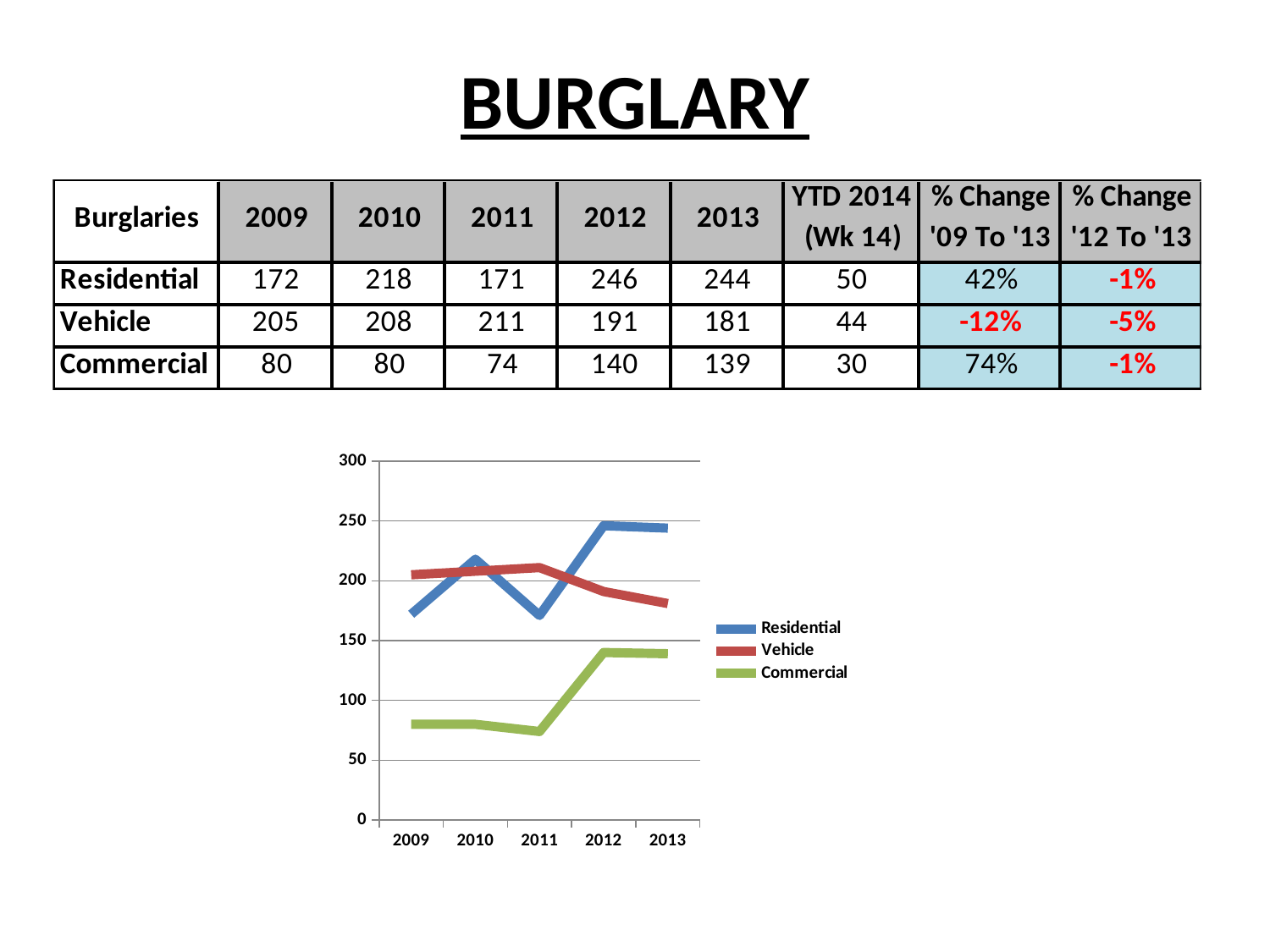
Does the Vehicle series rise or fall from 2011 to 2013? fall In 2011, which is larger, the Residential value or the Vehicle value? Vehicle Is the Commercial value for 2011 greater or less than 100? less Which series has the lowest values across all years in the chart? Commercial How many series does the chart's legend list? 3 What is the Residential burglary value for 2012, as shown in the table? 246 Which colour is used for the Commercial series in the chart? green What kind of chart is shown on the slide? line chart What is the difference between the Residential and Vehicle values in 2013, using the table values? 63 How many years are plotted along the x axis of the chart? 5 Which series has the highest value in 2012? Residential Is the Residential value for 2012 greater or less than 200? greater